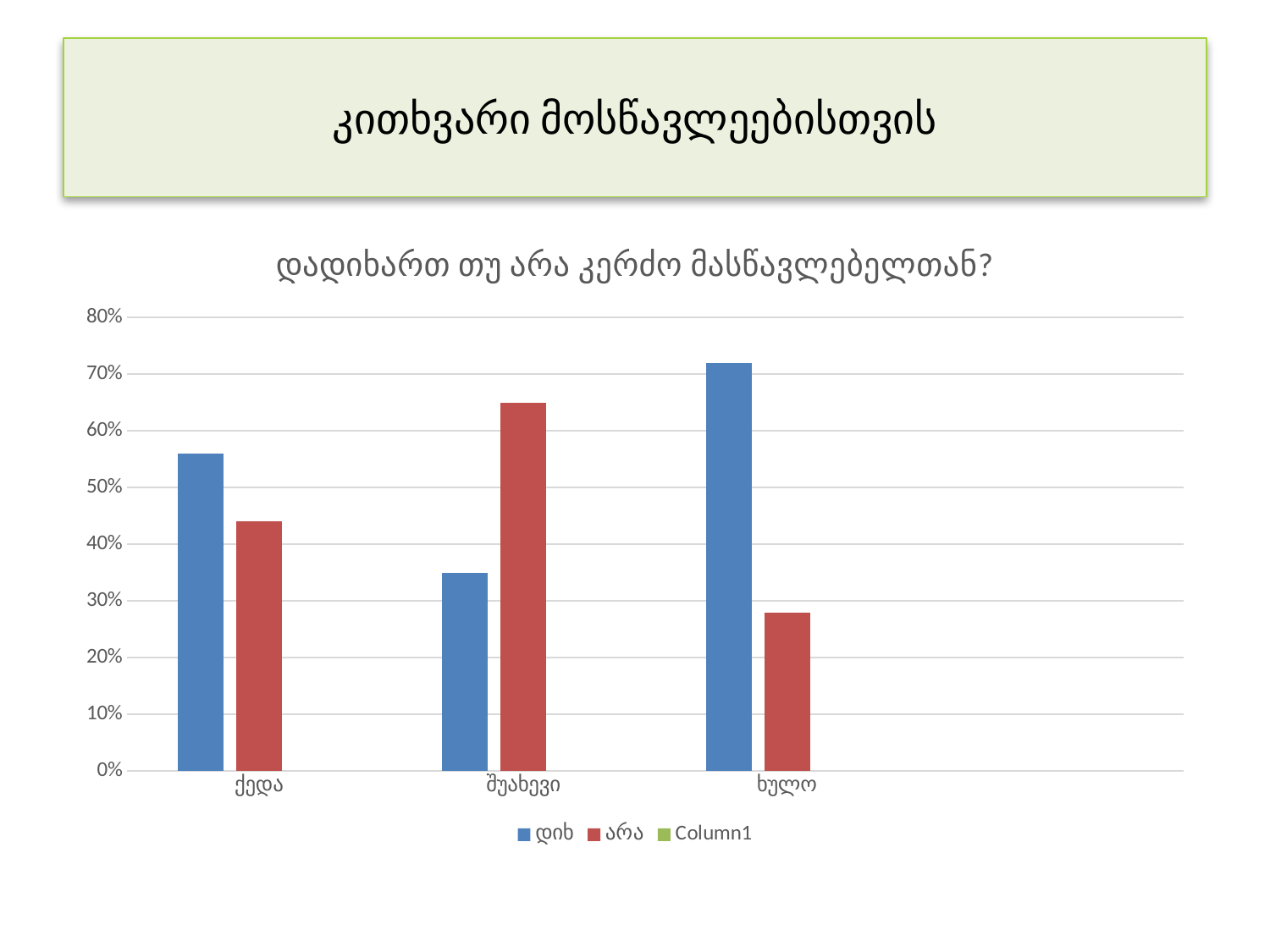
How many series does the chart legend list? 3 In ქედა, which is larger: the value for დიახ or the value for არა? დიახ Which category has the lowest value for the არა series? ხულო Which category has the lowest value for the დიახ series? შუახევი Is the value for დიახ in ხულო greater or less than 70%? greater What kind of chart is shown on the slide? bar chart Which category has the highest value for the დიახ series? ხულო Which category has the highest value for the არა series? შუახევი How many categories are shown on the x axis of the chart? 3 Is the value for არა in ხულო greater or less than 30%? less What is the title of the chart? დადიხართ თუ არა კერძო მასწავლებელთან? In შუახევი, which is larger: the value for დიახ or the value for არა? არა